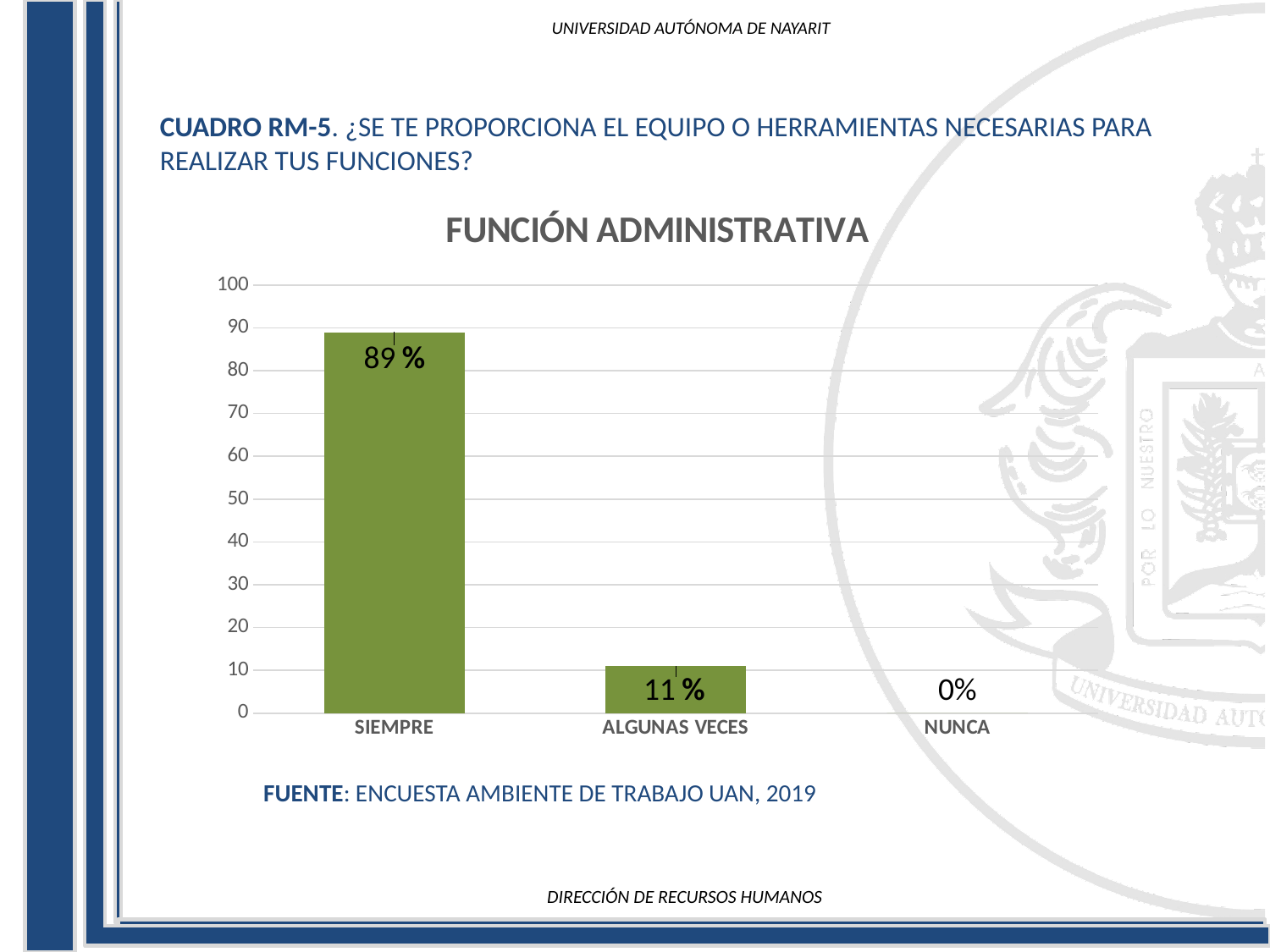
What kind of chart is shown? bar chart Is the value for ALGUNAS VECES greater or less than 20? less Which is larger, the value for SIEMPRE or the value for ALGUNAS VECES? SIEMPRE What is the value for NUNCA? 0% Is the value for SIEMPRE greater or less than 80? greater Which category has the lowest value? NUNCA What is the title of the chart? FUNCIÓN ADMINISTRATIVA What is the value for SIEMPRE? 89 % What is the value for ALGUNAS VECES? 11 % What is the difference between the values for SIEMPRE and ALGUNAS VECES? 78 % How many categories are shown on the x axis? 3 Which category has the highest value? SIEMPRE